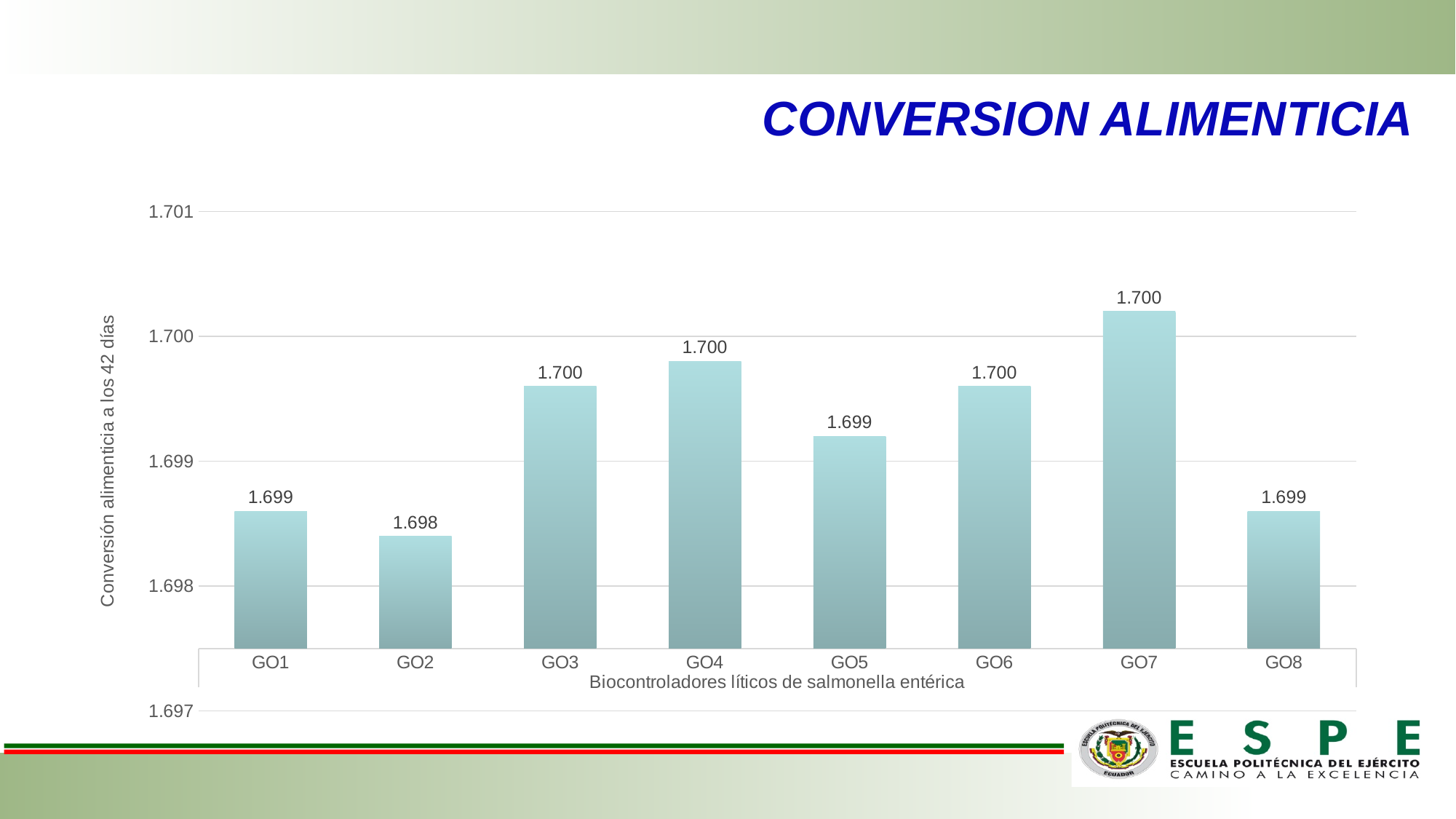
What is the value for GO5? 1.699 Which category has the lowest bar? GO2 Is the value for GO3 greater or less than 1.699? greater What is the title of the y axis? Conversión alimenticia a los 42 días How many categories are shown on the x axis? 8 What is the value for GO8? 1.699 What kind of chart is shown on the slide? Bar chart What is the value for GO2? 1.698 Is the value for GO2 greater or less than 1.699? less What is the value for GO4? 1.700 Which category has the highest bar? GO7